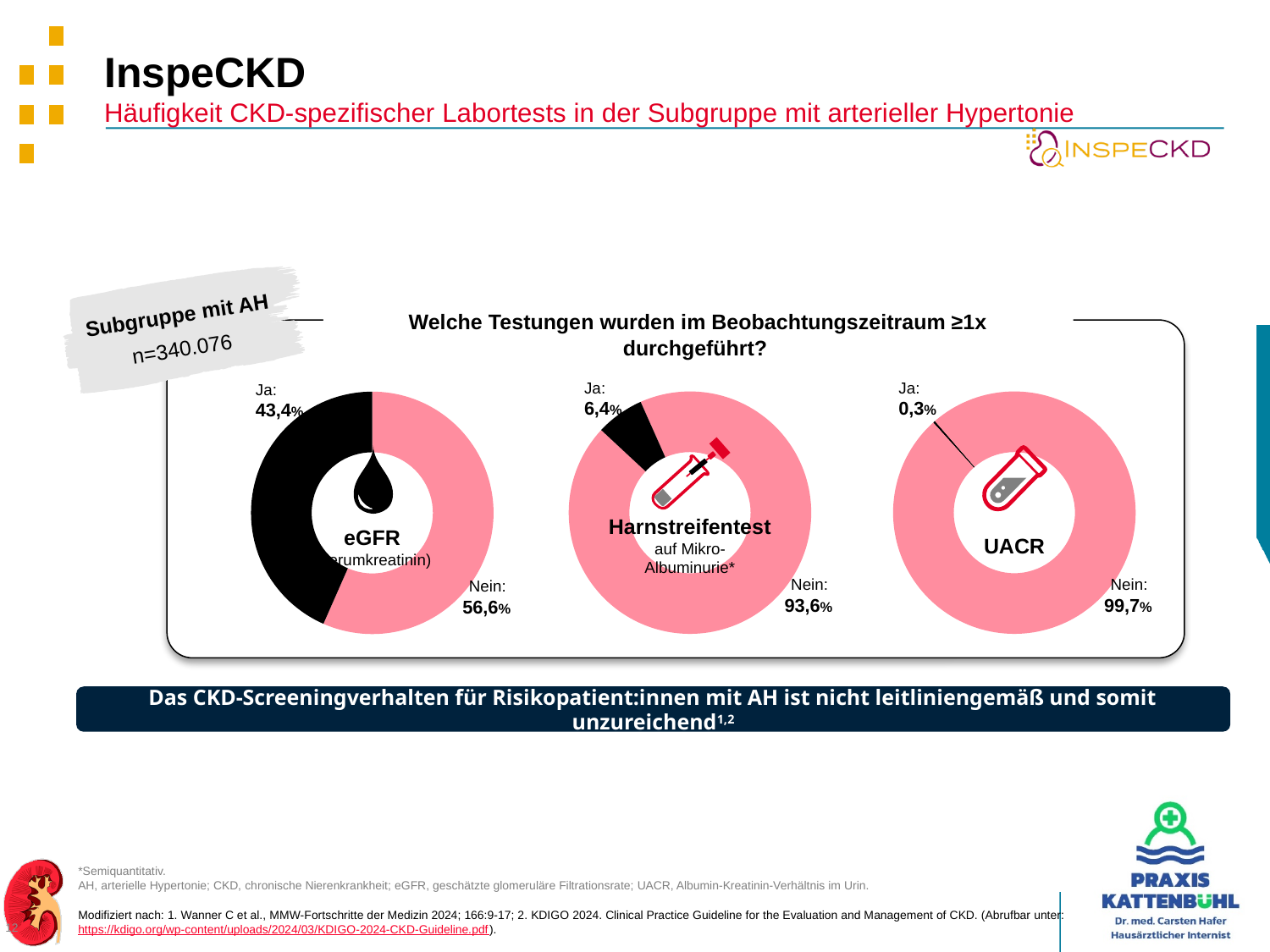
In the eGFR chart, what is the value for Nein? 56,6% In the UACR chart, what is the value for Nein? 99,7% What kind of chart is used to show the eGFR, Harnstreifentest and UACR results? Donut (pie) chart In the eGFR chart, what share of patients had the test performed at least once (Ja)? 43,4% In the UACR chart, what is the value for Ja? 0,3% Across the three charts, which test has the lowest Ja share? UACR In the Harnstreifentest chart, what is the value for Ja? 6,4% In the eGFR chart, what is the difference between the Nein and Ja shares? 13,2% Is the Ja share in the Harnstreifentest chart larger or smaller than the Ja share in the eGFR chart? smaller Across the three charts, which test has the highest Ja share? eGFR How many donut charts are shown on the slide? 3 In the Harnstreifentest chart, what is the value for Nein? 93,6%